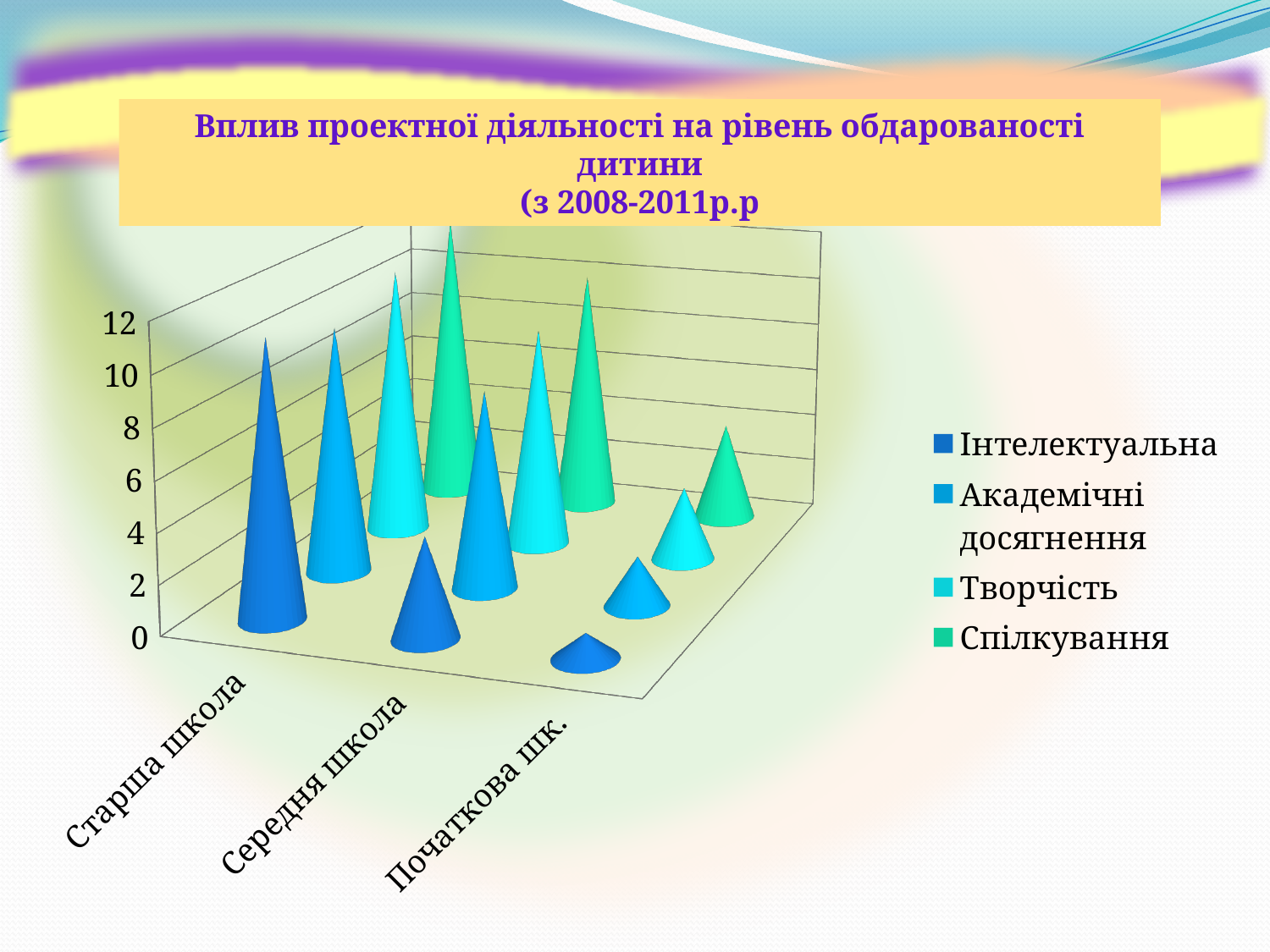
Which series has the highest value in the Початкова шк. category? Спілкування Which series is listed last in the chart legend? Спілкування Do the values for the Інтелектуальна series rise or fall from Старша школа to Початкова шк.? fall Which is larger: the Інтелектуальна value for Старша школа or for Початкова шк.? Старша школа Is the value for Інтелектуальна in Початкова шк. greater or less than 2? less Which category has the lowest value for the Інтелектуальна series? Початкова шк. Do the values for the Спілкування series rise or fall from Старша школа to Початкова шк.? fall How many categories are shown on the x axis of the chart? 3 What is the title of the chart? Вплив проектної діяльності на рівень обдарованості дитини (з 2008-2011р.р What kind of chart is shown on the slide? bar chart How many series does the chart legend list? 4 Which category has the highest value for the Інтелектуальна series? Старша школа